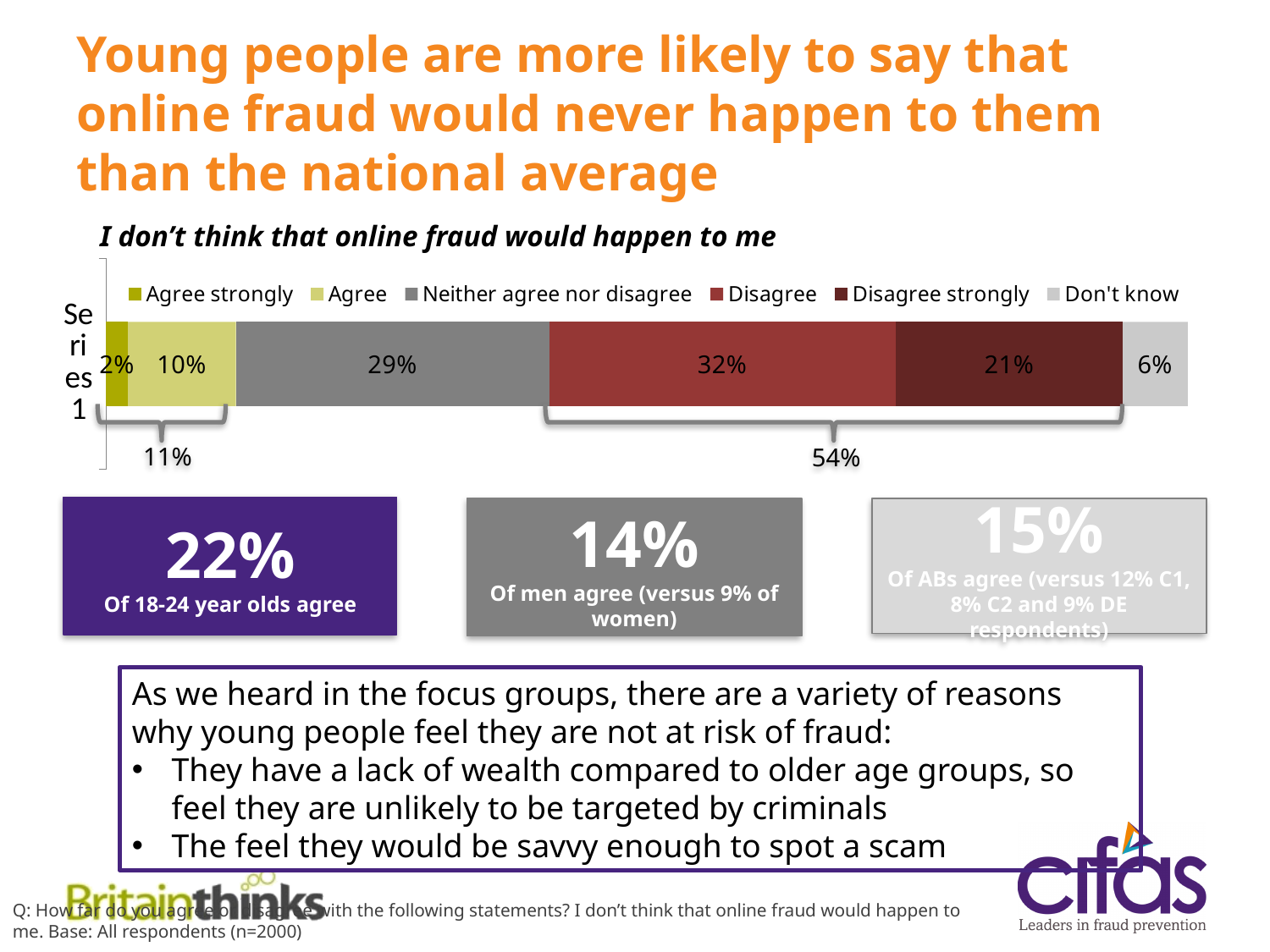
What percentage of respondents answered 'Agree strongly' in the chart? 2% What percentage of respondents answered 'Don't know' in the chart? 6% What is the combined share of 'Agree strongly' and 'Agree' in the chart? 11% Which response category has the largest share in the chart? Disagree What percentage of respondents answered 'Neither agree nor disagree' in the chart? 29% Which is larger in the chart: the 'Agree' share or the 'Disagree strongly' share? Disagree strongly How many series does the chart legend list? 6 What is the combined share of 'Disagree' and 'Disagree strongly' in the chart? 53% What is the difference between the 'Disagree' and 'Disagree strongly' shares in the chart? 11% Which response category has the smallest share in the chart? Agree strongly What percentage of respondents answered 'Disagree' in the chart? 32% What kind of chart is shown on the slide? Stacked bar chart